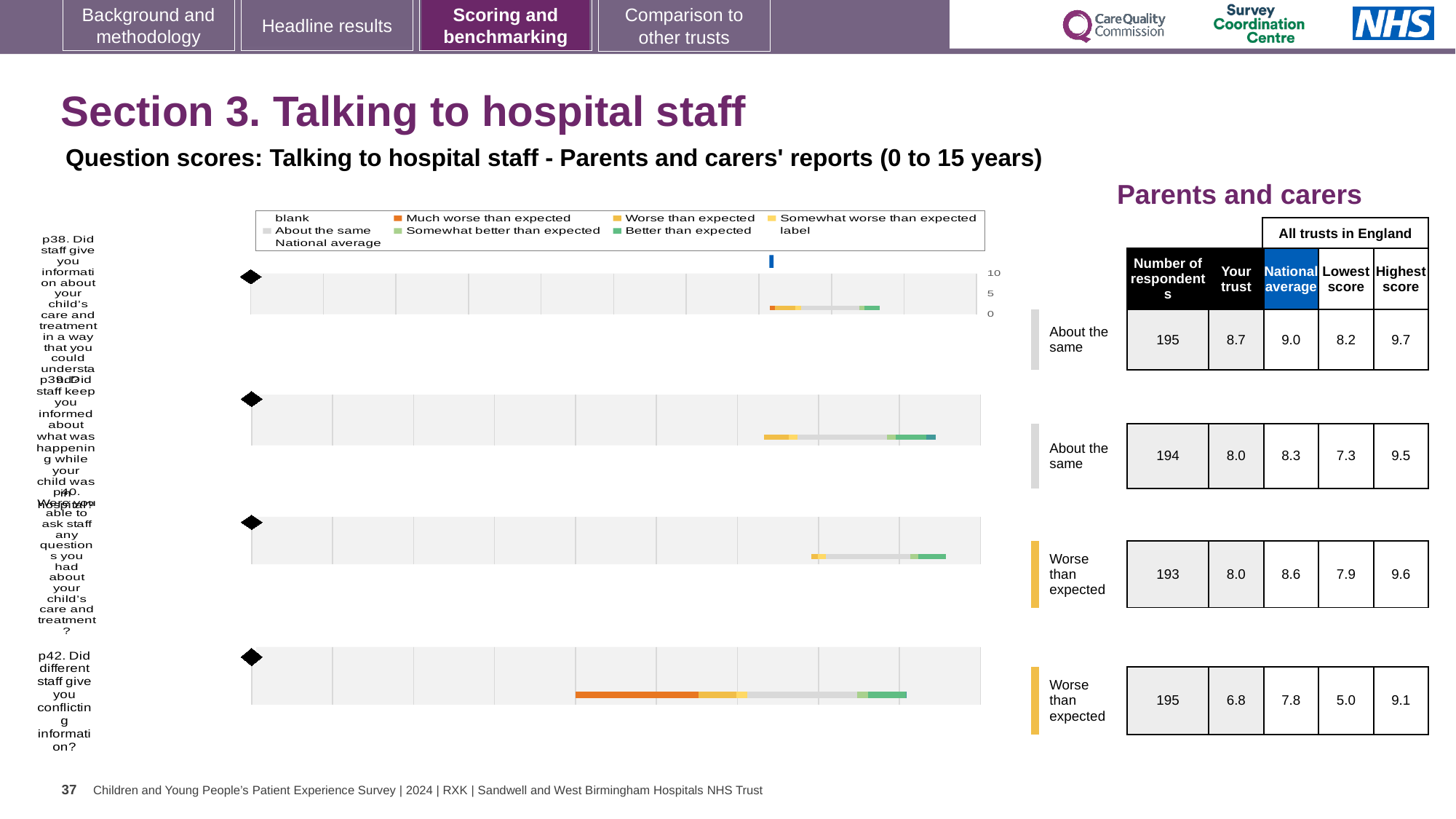
How many question-score charts (one per question) are shown on the slide? 4 What kind of chart is used for the question scores on this slide? Horizontal stacked bar chart For p40, which is larger: the 'Your trust' score or the national average? National average In the legend, what colour represents 'Better than expected'? Green Which question has the highest 'Your trust' score in the table beside the charts? p38 How many entries does the legend above the charts list? 9 Which question has the lowest 'Your trust' score in the table beside the charts? p42 What is the difference between the national average and the 'Your trust' score for p42? 1.0 How many respondents are listed for p39 in the table beside the charts? 194 In the legend, what colour represents 'Much worse than expected'? Orange According to the table beside the charts, what is the 'Your trust' score for p38 (staff giving information about your child's care and treatment in a way you could understand)? 8.7 According to the table beside the charts, what is the national average score for p42 (different staff giving conflicting information)? 7.8